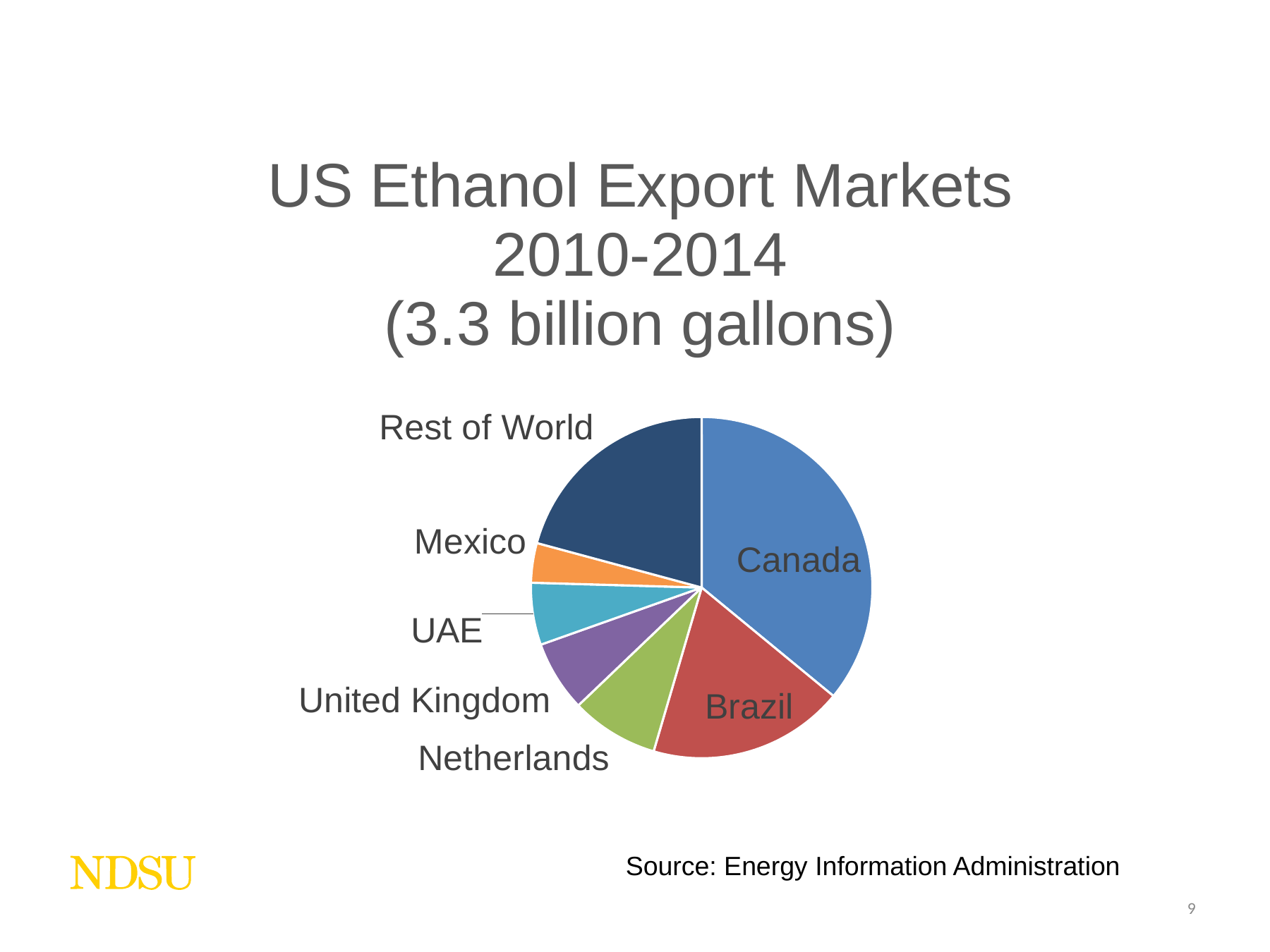
Which slice is larger, Brazil or United Kingdom? Brazil How many slices does the pie chart have? 7 Which slice is larger, Canada or Brazil? Canada What is the title of the chart on the slide? US Ethanol Export Markets 2010-2014 (3.3 billion gallons) Which export market has the largest slice of the pie chart? Canada Which slice is larger, Rest of World or UAE? Rest of World What kind of chart is shown on the slide? pie chart What source is cited for the chart data? Energy Information Administration